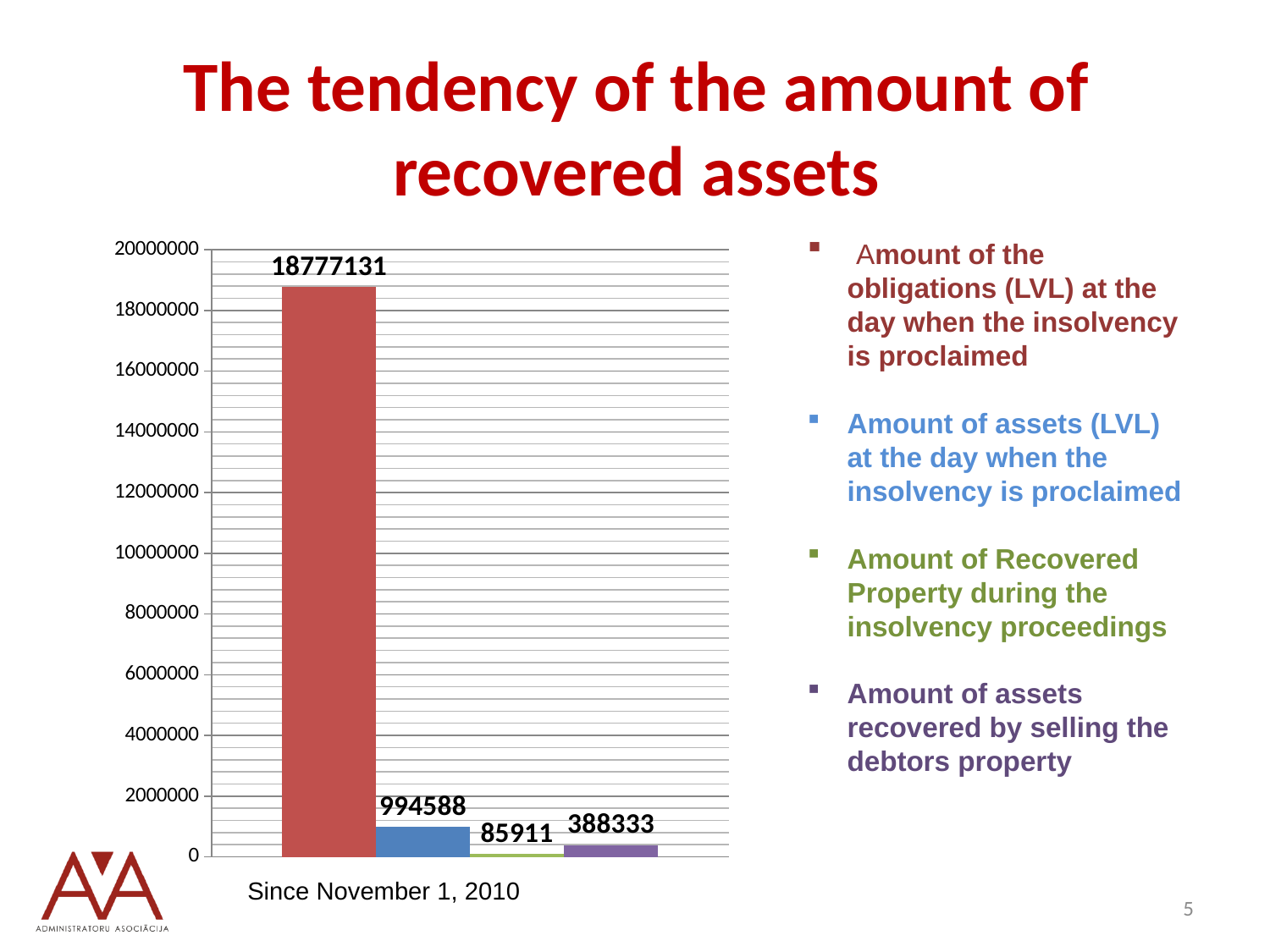
Is the value of the red bar greater or less than 18000000? greater What is the value of the blue bar, the amount of assets (LVL) at the day when the insolvency is proclaimed? 994588 Which series has the highest value on the chart? Amount of the obligations (LVL) at the day when the insolvency is proclaimed What is the value of the purple bar, the amount of assets recovered by selling the debtors property? 388333 What is the title of the slide containing the chart? The tendency of the amount of recovered assets Which is larger: the amount of assets (LVL) at the day when the insolvency is proclaimed or the amount of assets recovered by selling the debtors property? Amount of assets (LVL) at the day when the insolvency is proclaimed Which series has the lowest value on the chart? Amount of Recovered Property during the insolvency proceedings What kind of chart is shown on the slide? Bar chart What is the value of the red bar, the amount of the obligations (LVL) at the day when the insolvency is proclaimed? 18777131 How many bars are plotted on the chart? 4 What is the value of the green bar, the amount of recovered property during the insolvency proceedings? 85911 What is the difference between the amount of assets recovered by selling the debtors property and the amount of recovered property during the insolvency proceedings? 302422